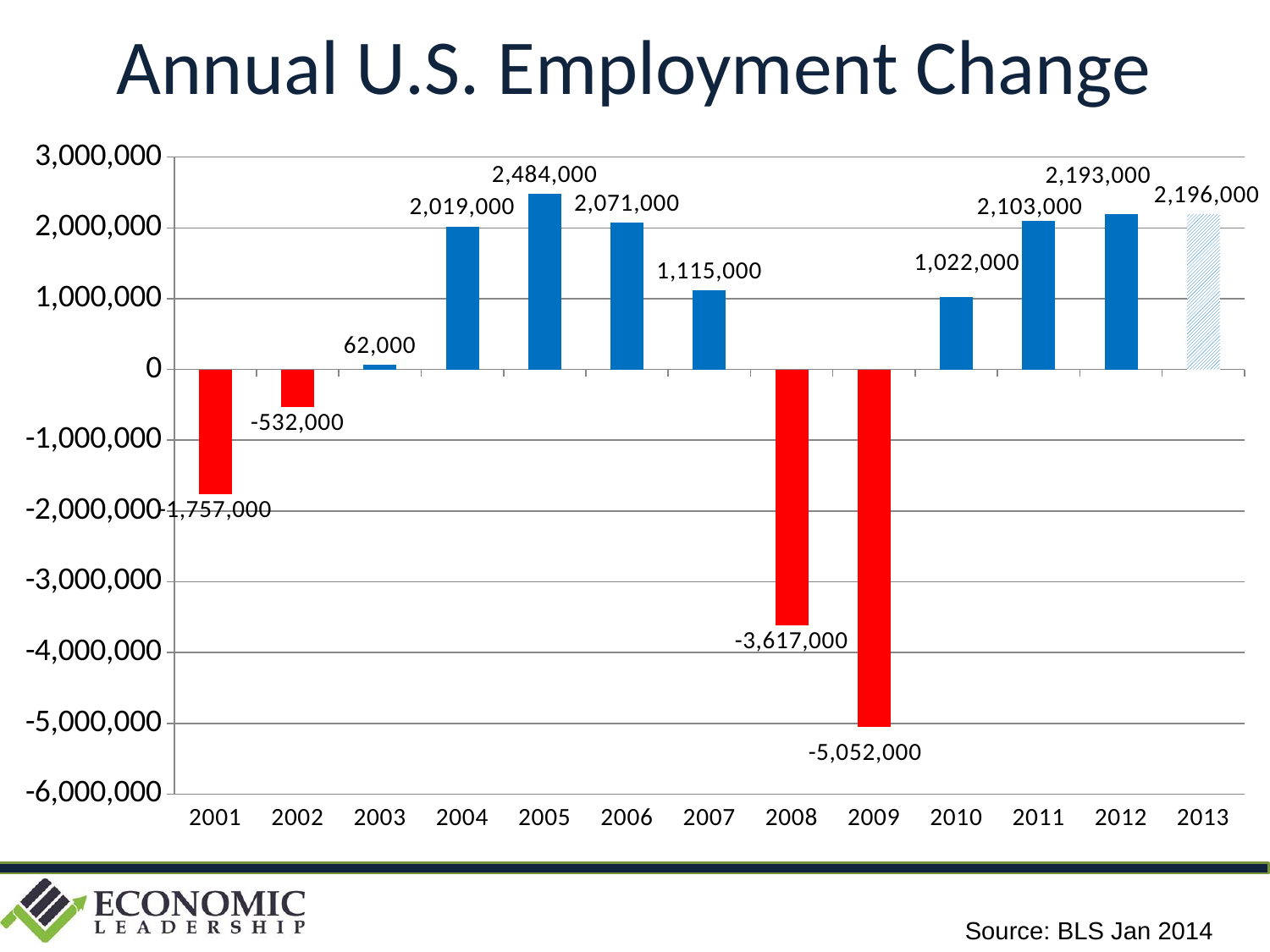
What is the title of the chart? Annual U.S. Employment Change Which year has the lowest employment change? 2009 What is the employment change shown for 2009? -5,052,000 What is the difference between the employment change in 2008 and in 2009? 1,435,000 What is the employment change shown for 2005? 2,484,000 What is the employment change shown for 2003? 62,000 Which year has the highest employment change? 2005 What kind of chart is shown on the slide? Bar chart Which year has the larger employment change, 2007 or 2010? 2007 Is the value for 2001 greater or less than -1,000,000? less How many years are shown on the x axis? 13 What is the employment change shown for 2013? 2,196,000